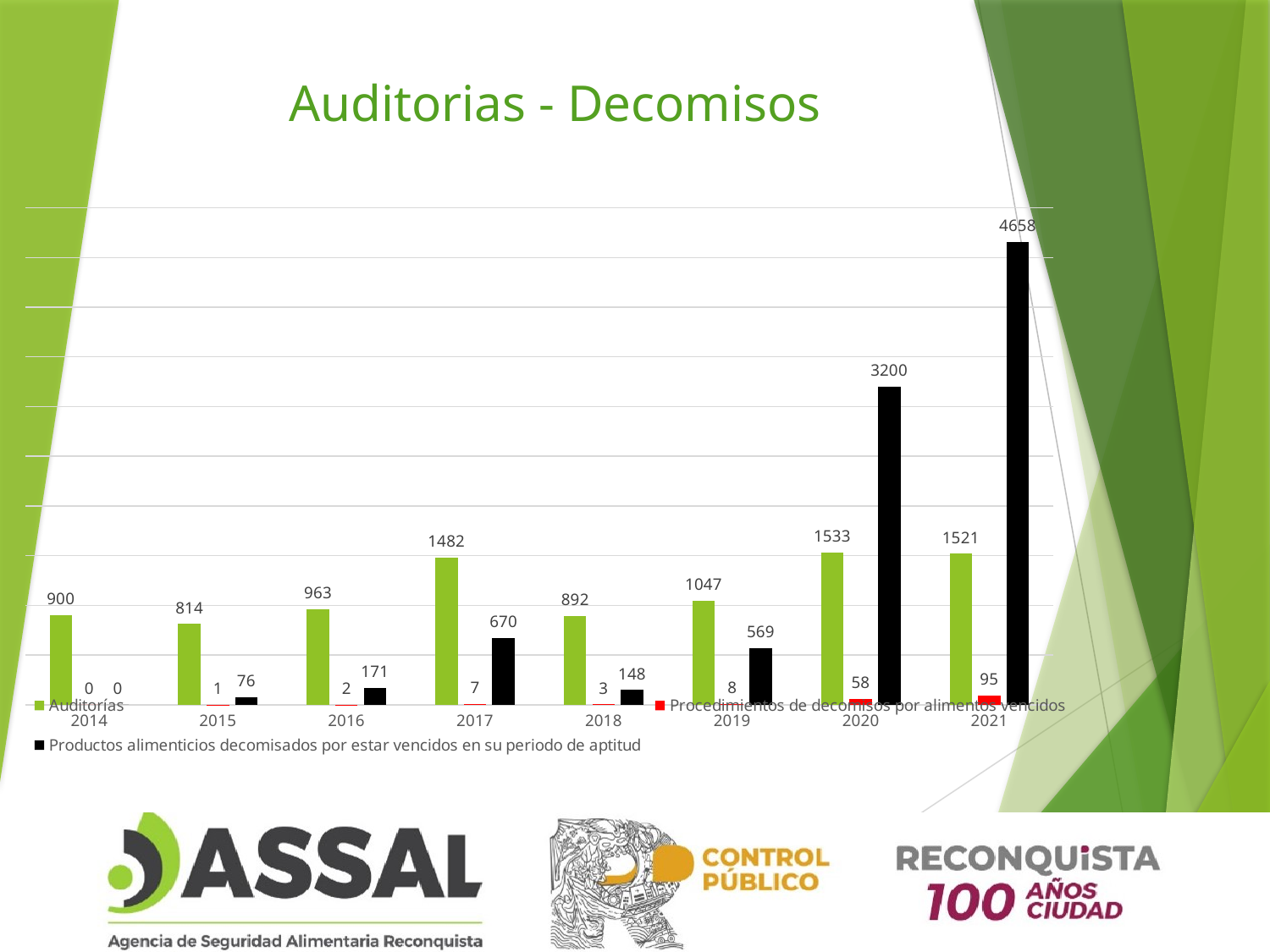
What is the title of the chart? Auditorias - Decomisos In which year is the value of Productos alimenticios decomisados por estar vencidos en su periodo de aptitud highest? 2021 How many years are shown on the x axis? 8 What type of chart is shown on the slide? Bar chart What is the value of Procedimientos de decomisos por alimentos vencidos in 2021? 95 What is the value of Productos alimenticios decomisados por estar vencidos en su periodo de aptitud in 2020? 3200 What is the value of Auditorías in 2017? 1482 How many series does the legend list? 3 Which is larger, the Auditorías value in 2016 or in 2018? 2016 What is the difference between the Productos alimenticios decomisados values for 2021 and 2020? 1458 In which year is the value of Auditorías lowest? 2015 What is the difference between the Auditorías values for 2020 and 2021? 12